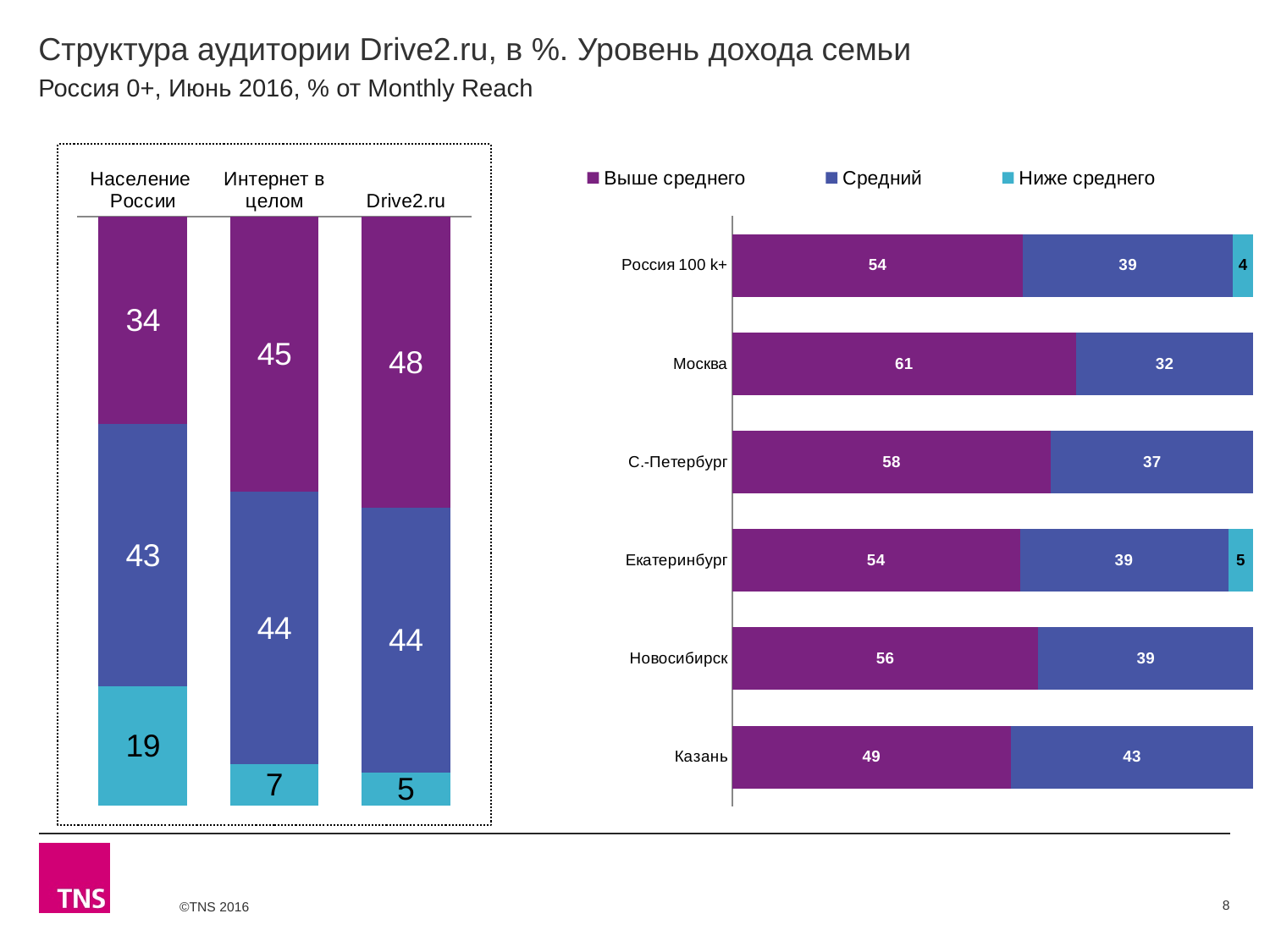
In the right chart, what is the value of the Выше среднего segment for Москва? 61 In the right chart, what is the value of the Средний segment for Казань? 43 In the left chart, what is the difference between the middle (blue) segment values for Население России and Drive2.ru? 1 How many categories are shown on the right chart? 6 In the left chart, what is the value of the top (purple) segment for Drive2.ru? 48 In the right chart, which city has the highest Выше среднего value? Москва In the left chart, what is the total of the three labelled segments for Интернет в целом? 96 What type of chart is the right chart? Stacked bar chart In the right chart, which category has the lowest Выше среднего value? Казань In the left chart, what is the value of the bottom (light blue) segment for Население России? 19 How many series does the legend on the right chart list? 3 In the right chart, which is larger: the Выше среднего value for С.-Петербург or for Новосибирск? С.-Петербург